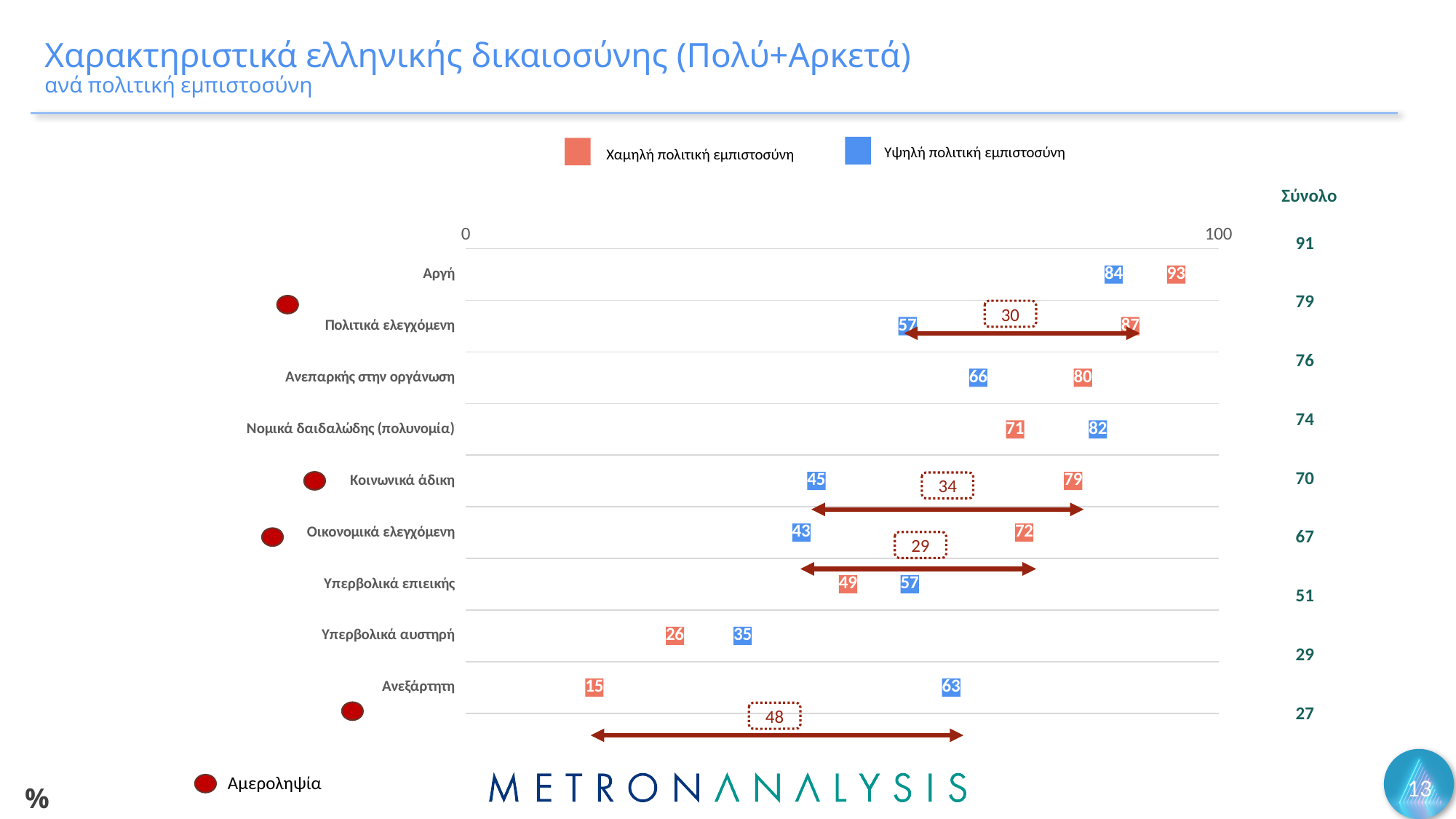
Which category has the lowest value in the Υψηλή πολιτική εμπιστοσύνη series? Υπερβολικά αυστηρή What is the value for Αργή in the Χαμηλή πολιτική εμπιστοσύνη series? 93 What is the difference between the Υψηλή and Χαμηλή πολιτική εμπιστοσύνη values for Ανεξάρτητη? 48 What colour represents the Υψηλή πολιτική εμπιστοσύνη series? Blue What is the difference between the Χαμηλή and Υψηλή πολιτική εμπιστοσύνη values for Πολιτικά ελεγχόμενη? 30 Which category has the highest value in the Χαμηλή πολιτική εμπιστοσύνη series? Αργή How many series does the legend list? 2 How many categories are plotted on the chart? 9 What is the Σύνολο value shown for Οικονομικά ελεγχόμενη? 67 What is the value for Ανεξάρτητη in the Υψηλή πολιτική εμπιστοσύνη series? 63 For Νομικά δαιδαλώδης (πολυνομία), which series has the larger value: Χαμηλή or Υψηλή πολιτική εμπιστοσύνη? Υψηλή πολιτική εμπιστοσύνη What is the value for Κοινωνικά άδικη in the Υψηλή πολιτική εμπιστοσύνη series? 45